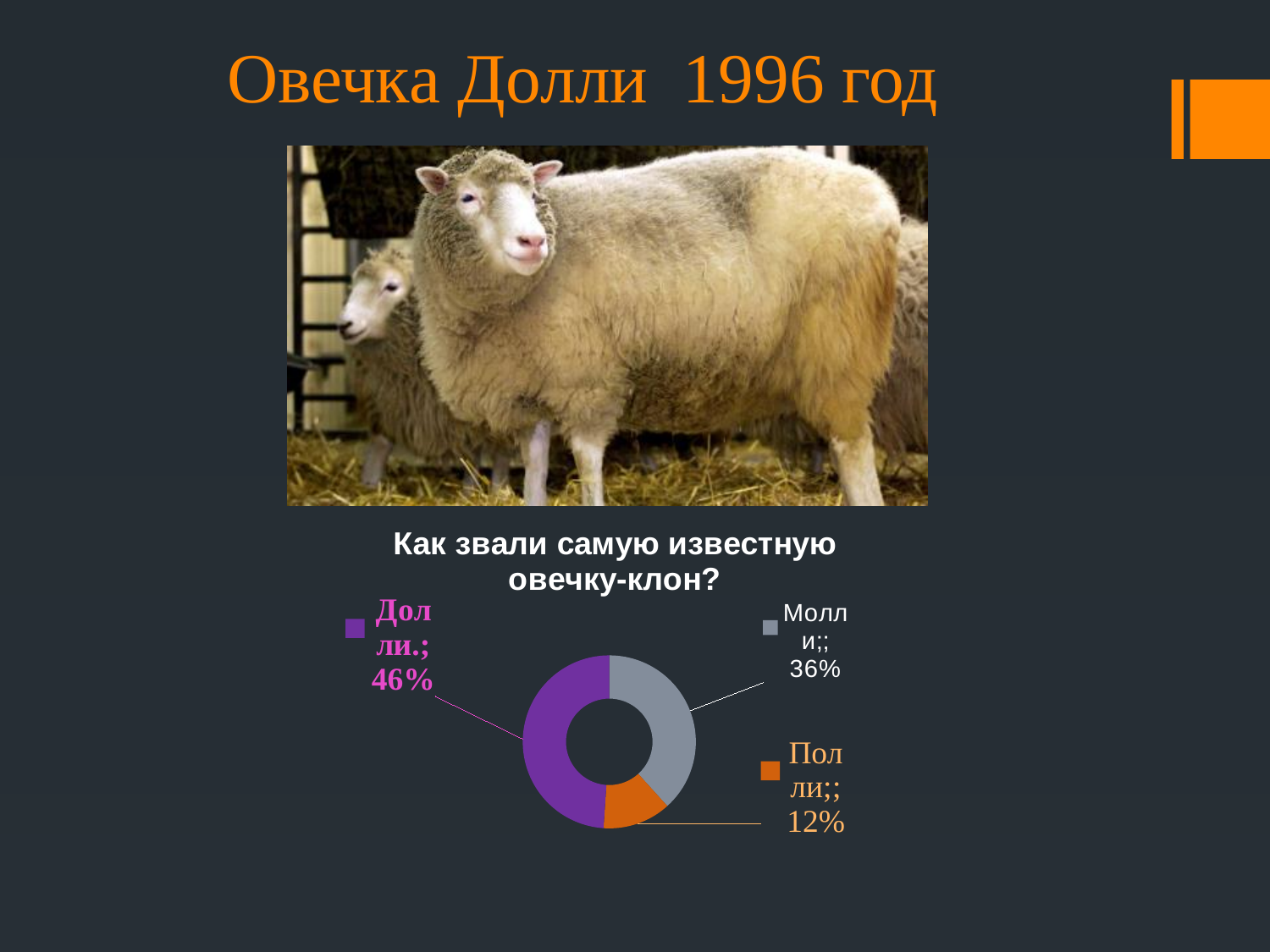
What colour is the slice for Полли? orange What is the difference in percentage points between Долли and Молли? 10 How many slices does the chart have? 3 What is the title of the chart? Как звали самую известную овечку-клон? What percentage is shown for Долли? 46% What percentage is shown for Полли? 12% What percentage is shown for Молли? 36% Which answer has the smallest share in the chart? Полли Which has a larger share, Молли or Полли? Молли Which answer has the largest share in the chart? Долли What is the difference in percentage points between Молли and Полли? 24 What kind of chart is shown on the slide? doughnut chart